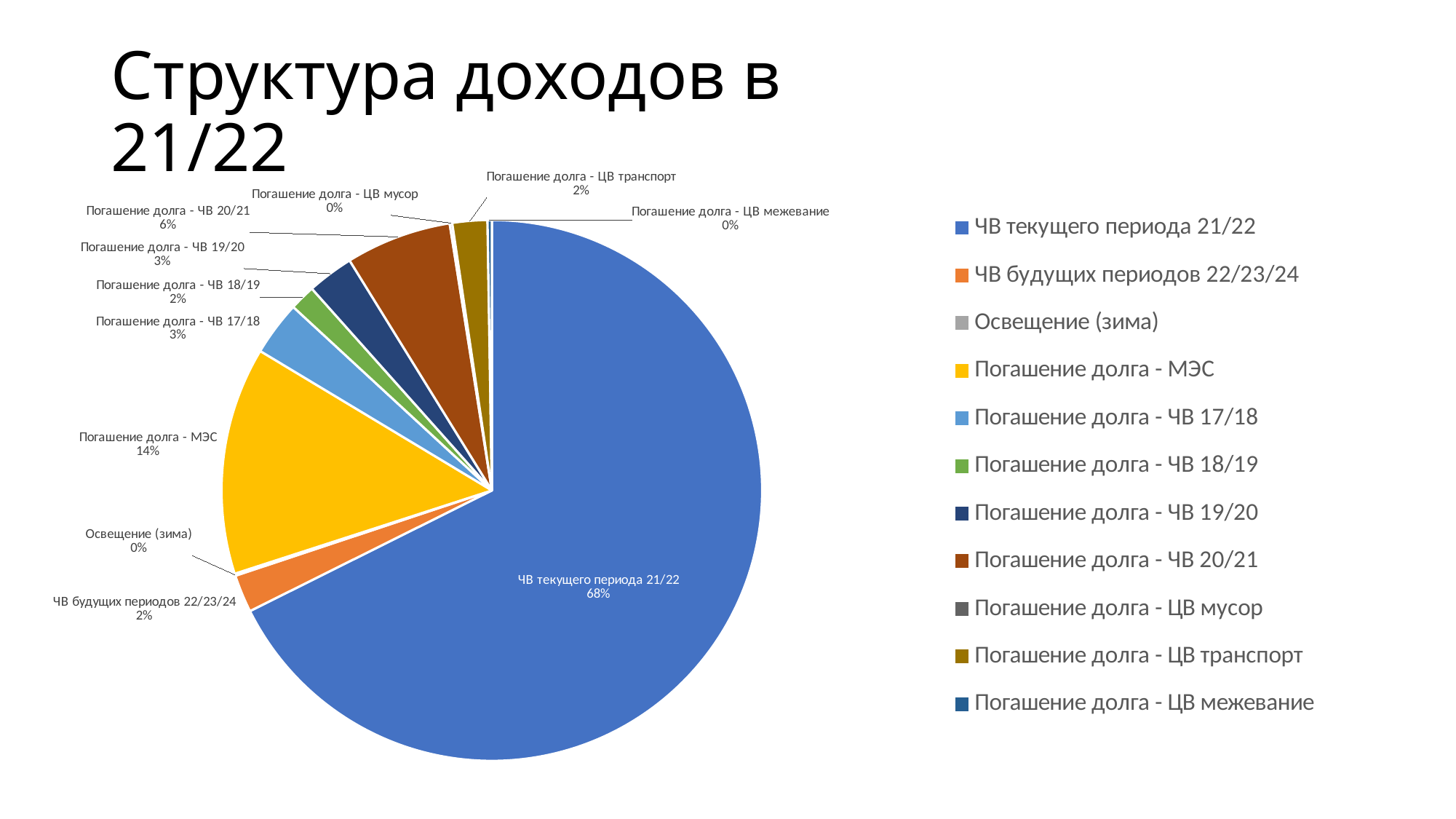
What is the difference between the shares of "ЧВ текущего периода 21/22" and "Погашение долга - МЭС"? 54% What is the value shown for "ЧВ будущих периодов 22/23/24"? 2% How many entries does the legend list? 11 Which category has the largest slice of the pie? ЧВ текущего периода 21/22 What share of the pie does "ЧВ текущего периода 21/22" take? 68% What share of the pie does "Погашение долга - МЭС" take? 14% Which is larger: the share of "Погашение долга - ЧВ 20/21" or "Погашение долга - ЧВ 19/20"? Погашение долга - ЧВ 20/21 What is the title of the slide? Структура доходов в 21/22 What is the value shown for "Погашение долга - ЧВ 17/18"? 3% What is the value shown for "Погашение долга - ЧВ 20/21"? 6% What is the value shown for "Погашение долга - ЦВ транспорт"? 2% What kind of chart is shown on the slide? pie chart